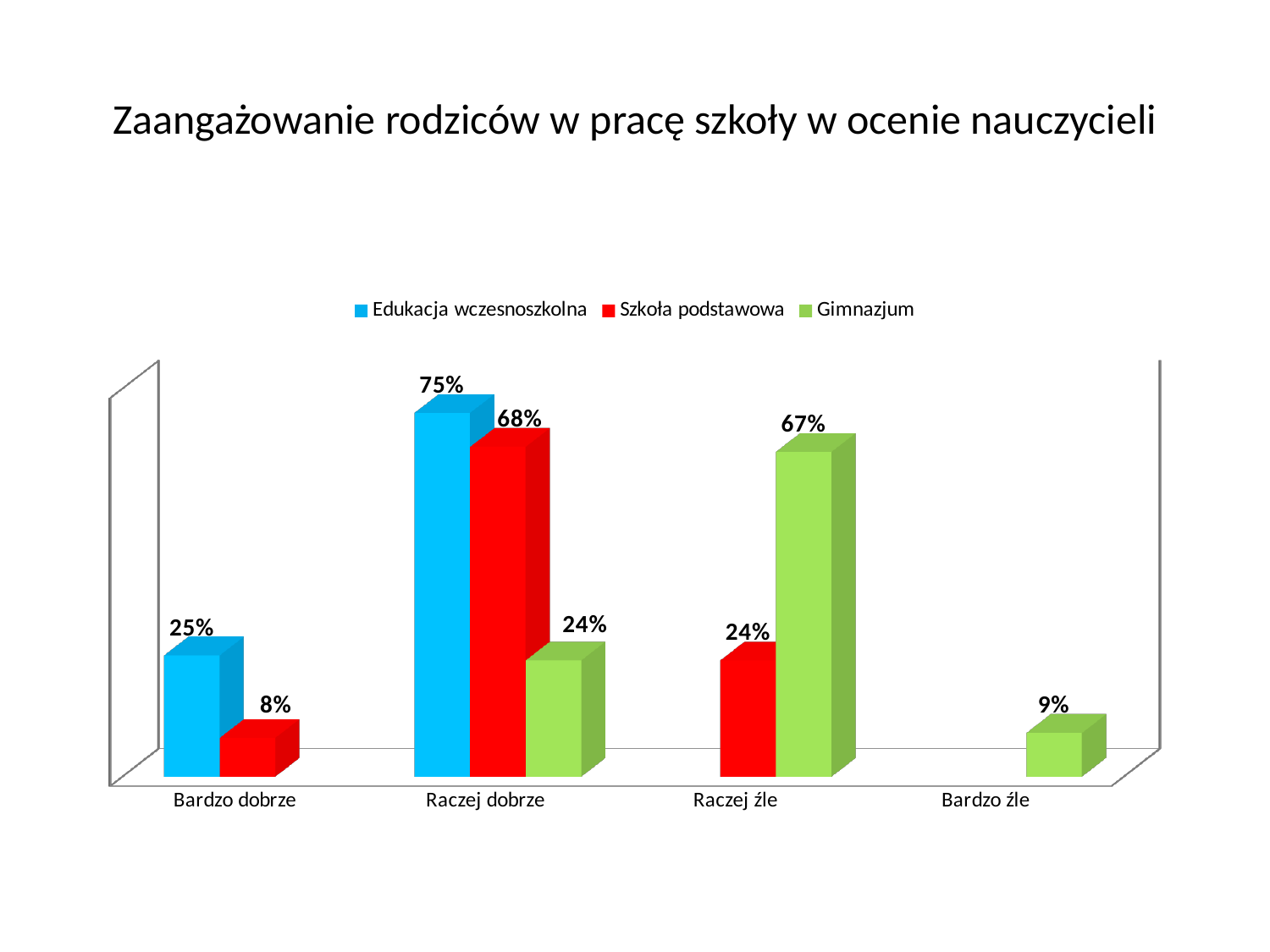
How many categories are shown on the x axis? 4 What is the difference between the Edukacja wczesnoszkolna and Szkoła podstawowa values in the Raczej dobrze category? 7% What is the value for Szkoła podstawowa in the Raczej dobrze category? 68% How many series does the legend list? 3 What is the value for Gimnazjum in the Bardzo źle category? 9% What is the value for Edukacja wczesnoszkolna in the Bardzo dobrze category? 25% What kind of chart is shown on the slide? Bar chart Which category has the highest value for Edukacja wczesnoszkolna? Raczej dobrze What is the value for Gimnazjum in the Raczej źle category? 67% Which is larger in the Raczej źle category: Szkoła podstawowa or Gimnazjum? Gimnazjum What colour represents the Gimnazjum series? Green Which category has the lowest value for Szkoła podstawowa? Bardzo dobrze